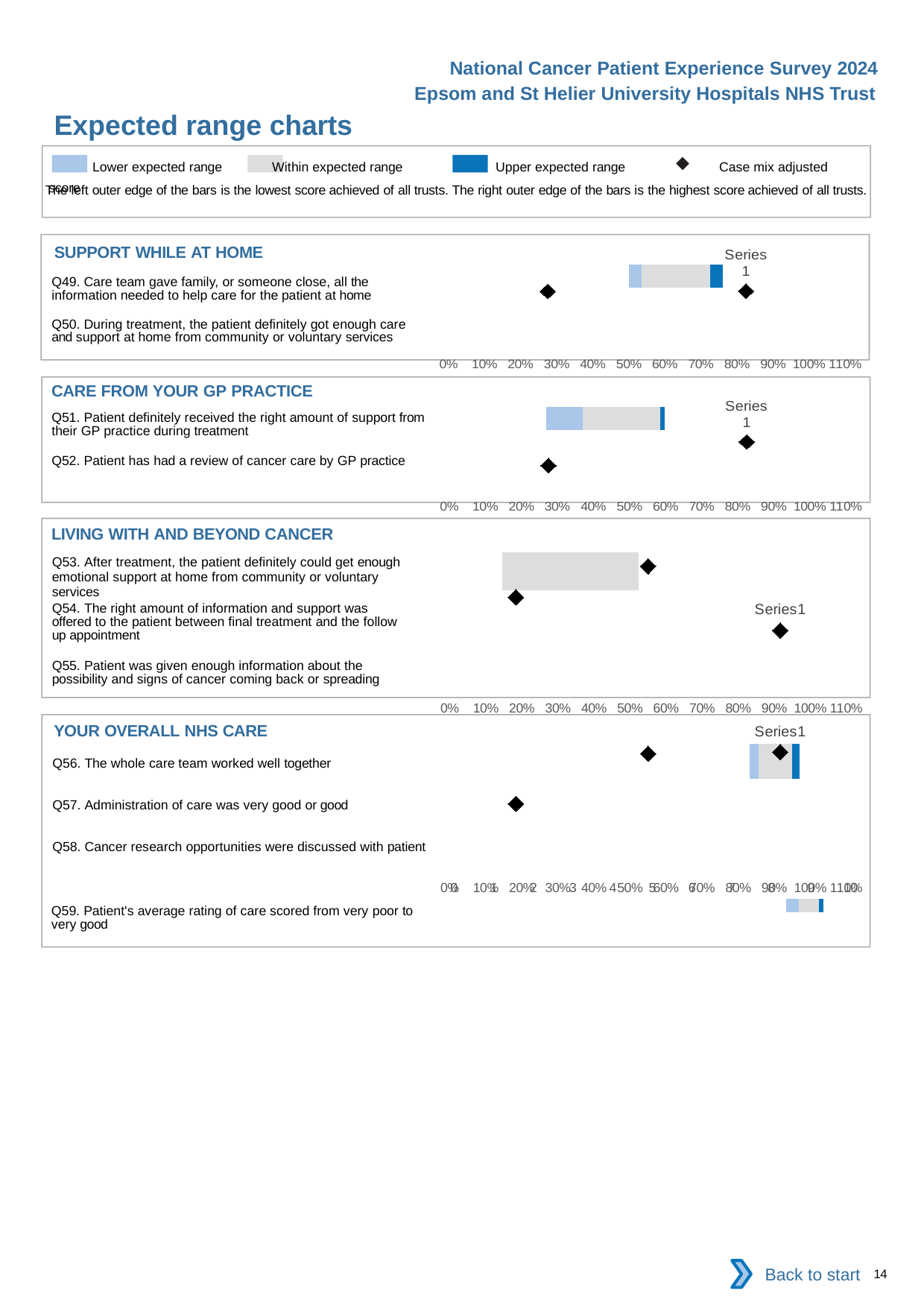
According to the legend, what does the black diamond marker represent? Case mix adjusted score What kind of chart is used in the 'SUPPORT WHILE AT HOME' section? bar chart How many questions (categories) are listed in the 'YOUR OVERALL NHS CARE' chart? 4 In the 'CARE FROM YOUR GP PRACTICE' chart, is the diamond plotted in the Q52 row greater or less than 50%? less How many questions (categories) are listed in the 'CARE FROM YOUR GP PRACTICE' chart? 2 What is the highest tick label shown on the x axis of the 'SUPPORT WHILE AT HOME' chart? 110% How many questions (categories) are listed in the 'LIVING WITH AND BEYOND CANCER' chart? 3 How many entries does the legend at the top of the slide list? 4 In the 'YOUR OVERALL NHS CARE' chart, is the diamond plotted in the Q57 row greater or less than 30%? less